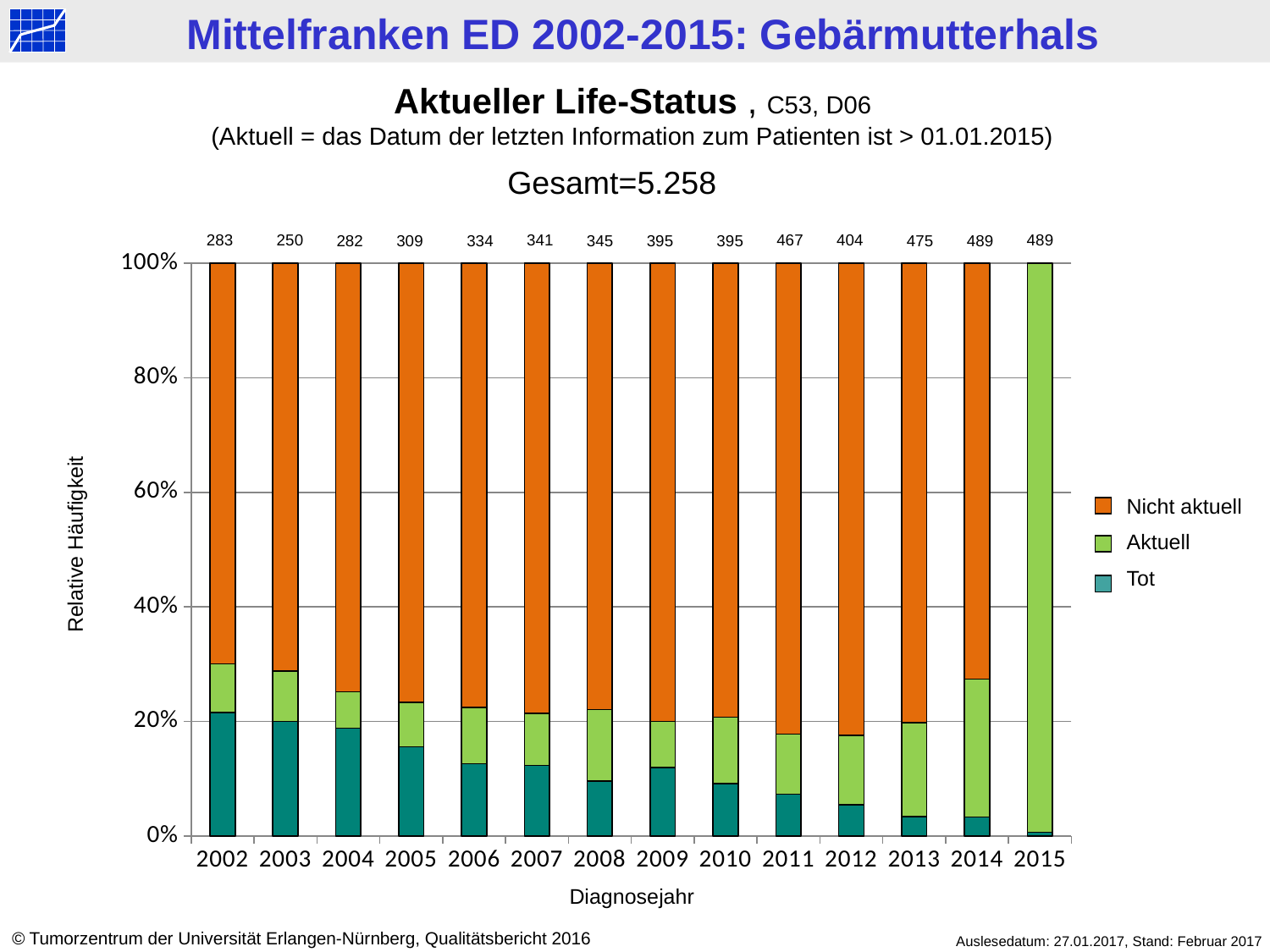
How many series does the legend list? 3 Which year has more cases printed above its bar, 2011 or 2012? 2011 Is the 'Nicht aktuell' share for 2002 greater or less than 60%? greater What is the difference between the case counts printed for 2013 and 2012? 71 Is the 'Aktuell' share for 2015 greater or less than 80%? greater How many diagnosis years are shown on the x axis? 14 Which diagnosis year has the lowest number of cases printed above its bar? 2003 Does the 'Tot' share rise or fall from 2002 to 2015? fall How many cases are shown above the bar for 2011? 467 Is the 'Tot' share for 2005 greater or less than 20%? less How many cases are shown above the bar for 2006? 334 What kind of chart is shown on the slide? stacked bar chart